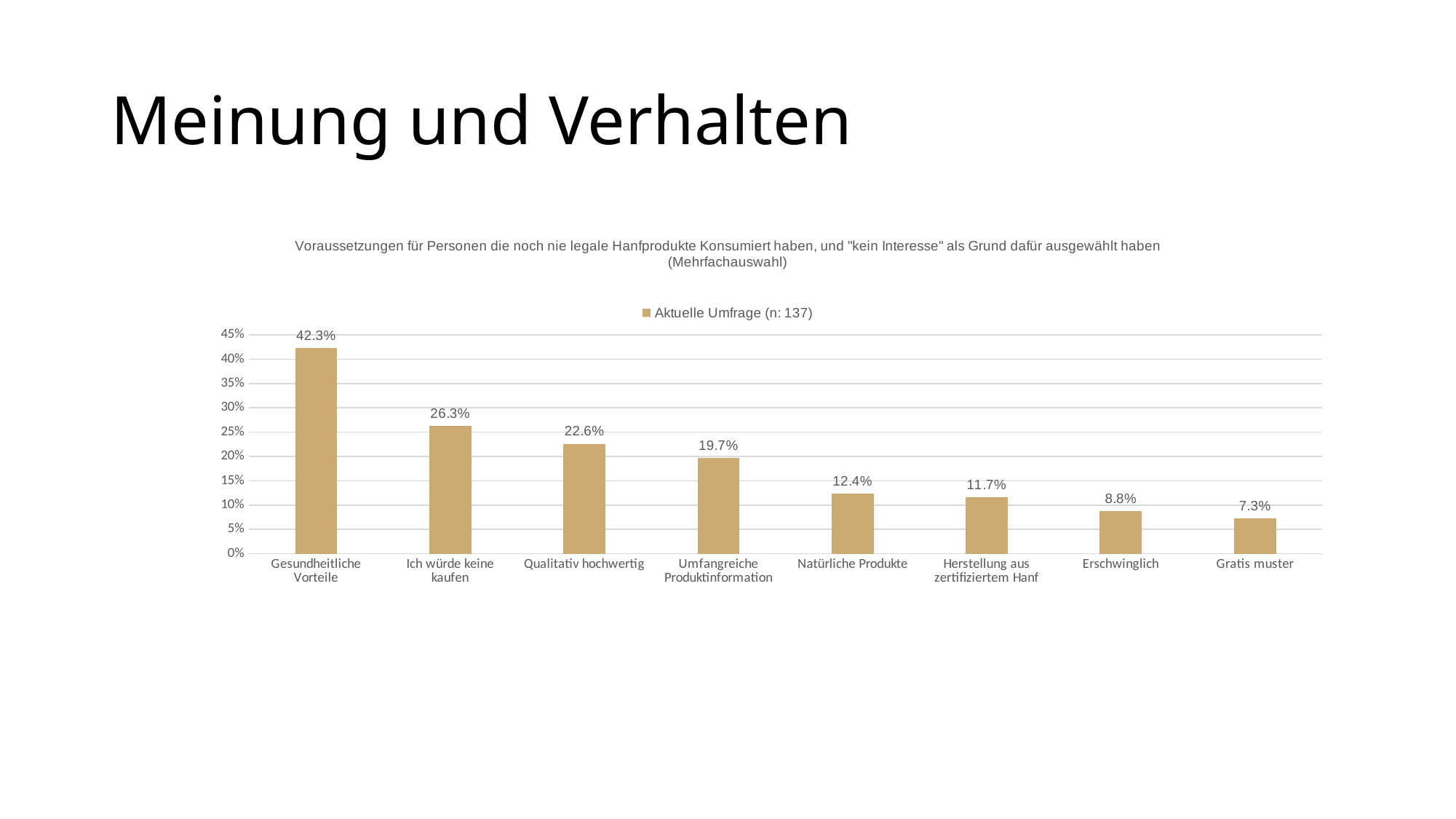
What is the difference between "Ich würde keine kaufen" and "Qualitativ hochwertig"? 3.7% What is the value for "Gesundheitliche Vorteile"? 42.3% Which category has the lowest value? Gratis muster Is the value for "Qualitativ hochwertig" greater or less than 20%? greater What is the value for "Erschwinglich"? 8.8% What is the legend entry of the series shown? Aktuelle Umfrage (n: 137) What kind of chart is shown? bar chart Which category has the highest value? Gesundheitliche Vorteile How many series does the legend list? 1 How many categories are shown on the x axis? 8 Which is larger: "Natürliche Produkte" or "Herstellung aus zertifiziertem Hanf"? Natürliche Produkte What is the value for "Umfangreiche Produktinformation"? 19.7%